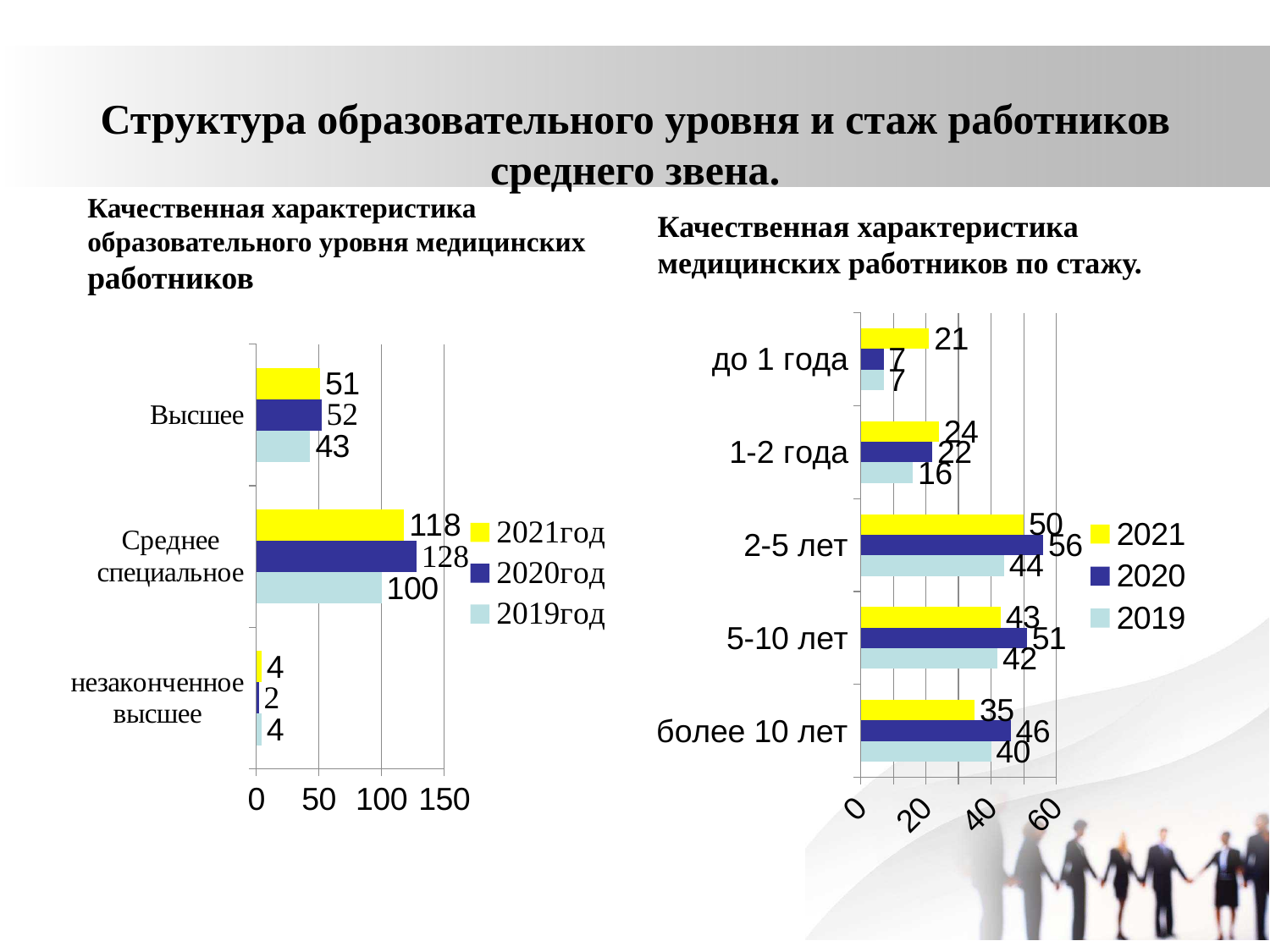
In the right chart (Качественная характеристика медицинских работников по стажу), what is the value for до 1 года in 2021? 21 In the right chart (Качественная характеристика медицинских работников по стажу), what is the value for 2-5 лет in 2020? 56 In the left chart (Качественная характеристика образовательного уровня медицинских работников), what is the value for Среднее специальное in 2020год? 128 In the left chart (Качественная характеристика образовательного уровня медицинских работников), what is the difference between the 2020год and 2019год values for Среднее специальное? 28 In the left chart (Качественная характеристика образовательного уровня медицинских работников), how many series does the legend list? 3 In the right chart (Качественная характеристика медицинских работников по стажу), which is larger for более 10 лет: the 2020 value or the 2021 value? 2020 In the left chart (Качественная характеристика образовательного уровня медицинских работников), what is the value for Высшее in 2019год? 43 In the left chart (Качественная характеристика образовательного уровня медицинских работников), which category has the highest value in 2021год? Среднее специальное In the right chart (Качественная характеристика медицинских работников по стажу), what is the difference between the 2020 and 2021 values for 5-10 лет? 8 In the left chart (Качественная характеристика образовательного уровня медицинских работников), what kind of chart is shown? bar chart In the right chart (Качественная характеристика медицинских работников по стажу), which category has the lowest value in 2019? до 1 года In the right chart (Качественная характеристика медицинских работников по стажу), how many categories are shown? 5